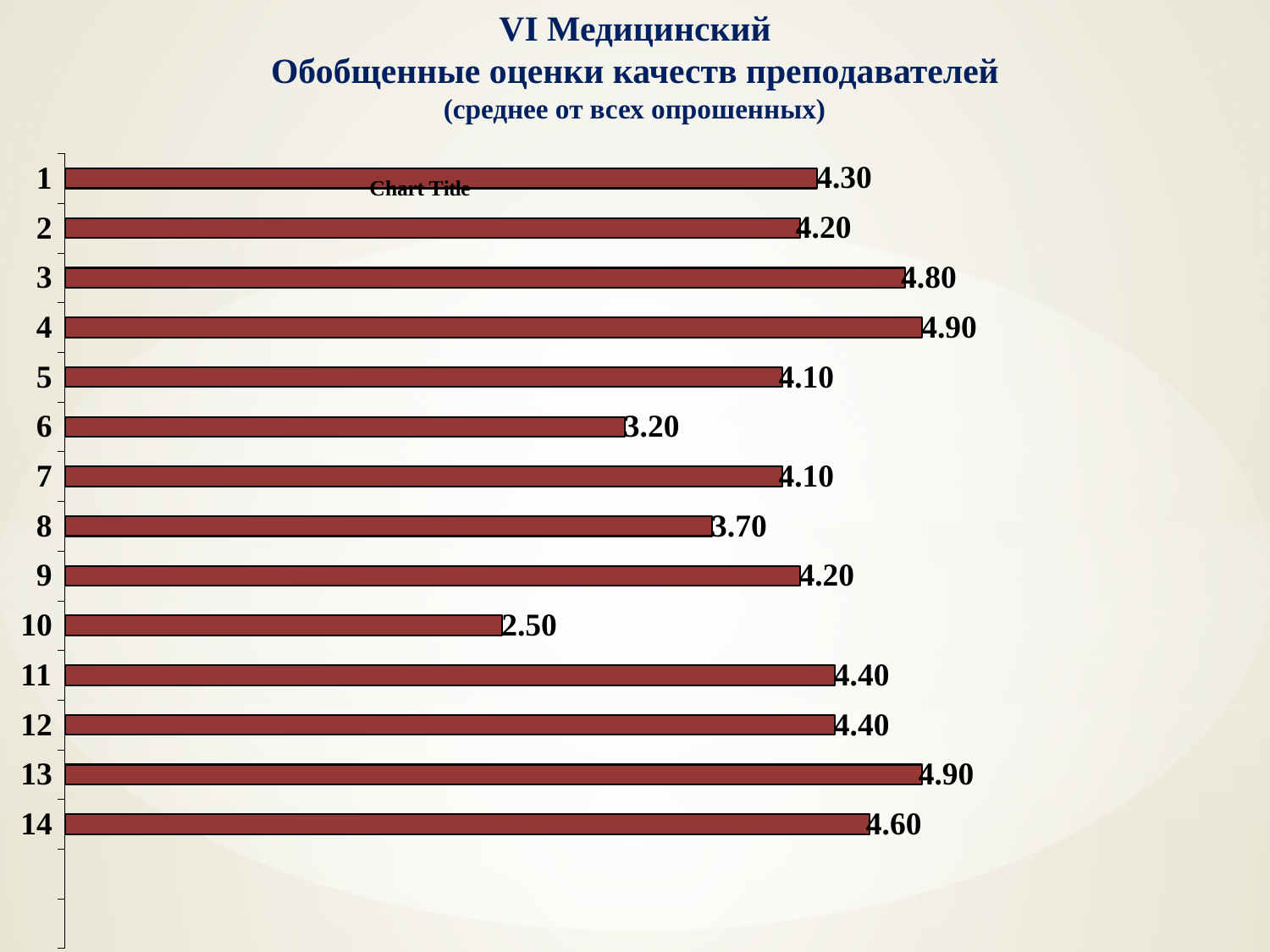
Which has a larger value, category 11 or category 5? 11 How many categories are shown on the chart? 14 Which category has the lowest value? 10 What is the highest value shown on the chart? 4.90 What is the value for category 6? 3.20 What is the value for category 8? 3.70 Which has a larger value, category 6 or category 8? 8 What is the value for category 1? 4.30 What is the value for category 14? 4.60 What is the difference between the values for category 3 and category 2? 0.60 What kind of chart is shown on the slide? bar chart What is the difference between the values for category 4 and category 10? 2.40